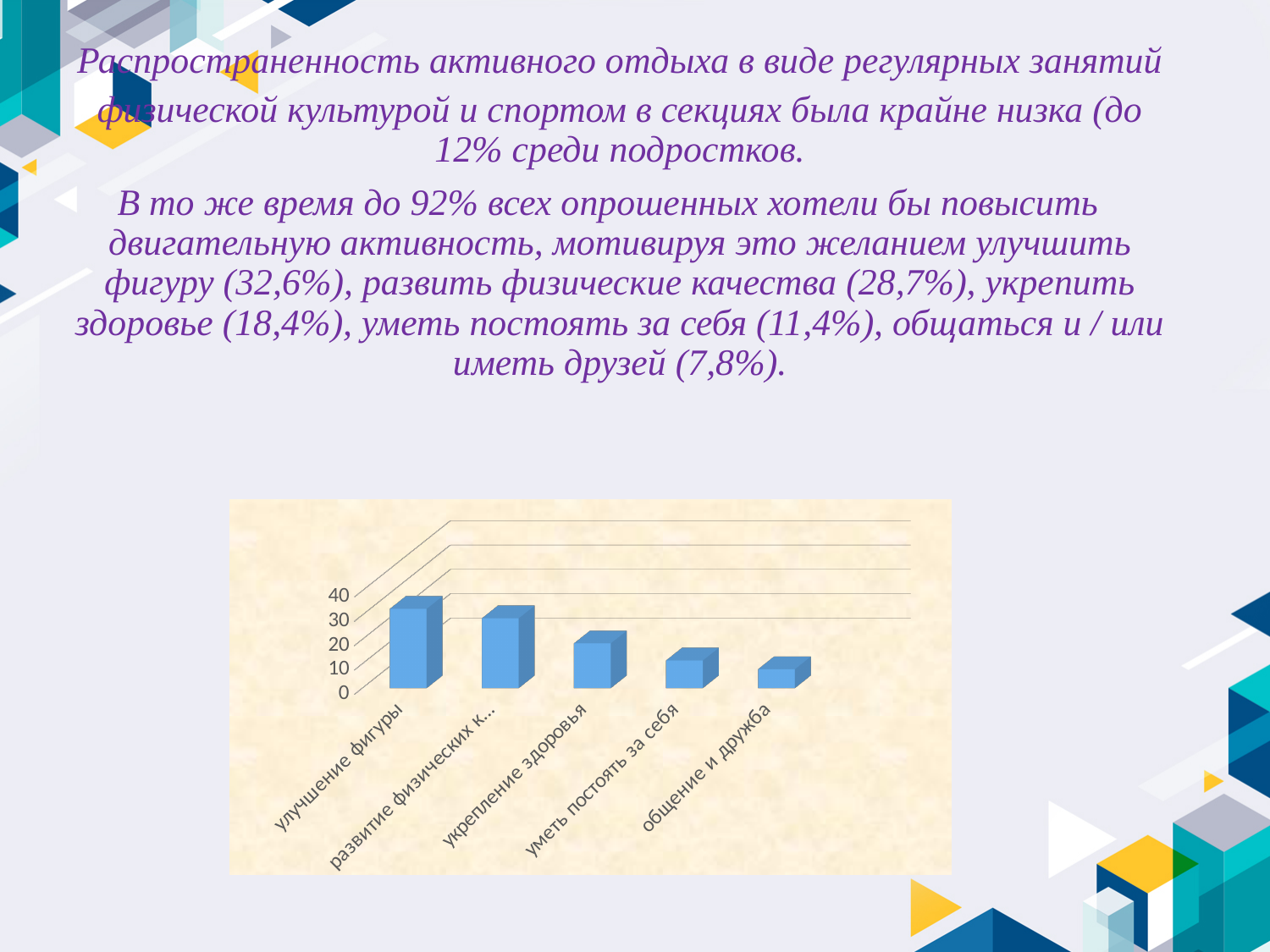
Which category has the lowest bar in the chart? общение и дружба Do the bar values rise or fall from left to right along the x axis? fall Which is larger in the chart, the value for улучшение фигуры or the value for укрепление здоровья? улучшение фигуры Is the value for улучшение фигуры greater or less than 20? greater What colour are the bars in the chart? blue Which category has the highest bar in the chart? улучшение фигуры Is the value for развитие физических к... greater or less than 20? greater Which is larger in the chart, the value for уметь постоять за себя or the value for развитие физических к...? развитие физических к... How many categories are plotted in the chart? 5 Is the value for общение и дружба greater or less than 10? less What kind of chart is shown on the slide? bar chart